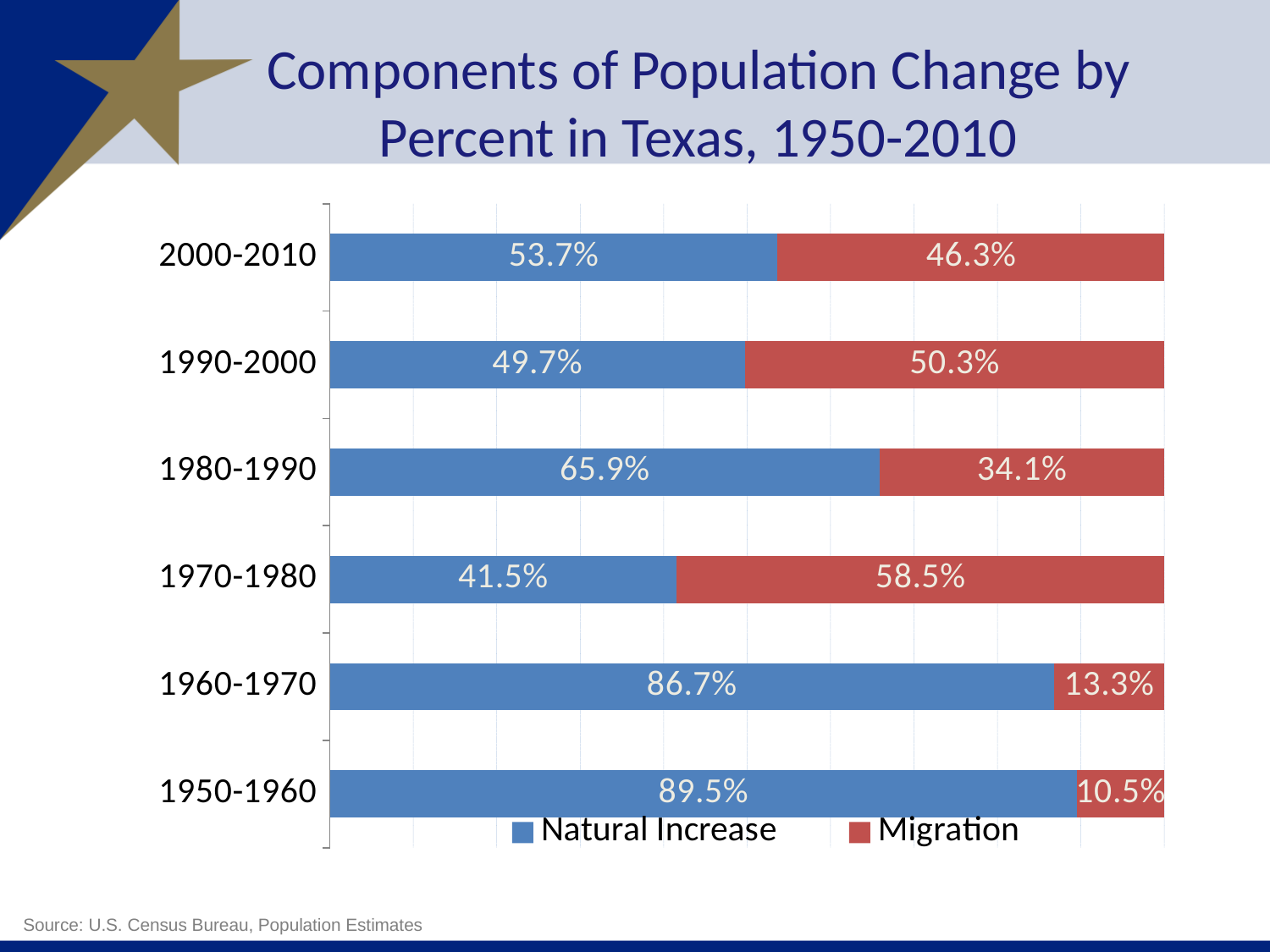
What is the Migration value for 1970-1980? 58.5% What colour represents Migration in the chart? Red How many series does the legend list? 2 What is the Migration value for 1950-1960? 10.5% What is the difference between the Natural Increase and Migration values for 1980-1990? 31.8% What is the Natural Increase value for 2000-2010? 53.7% How many time periods are shown on the chart? 6 For 1990-2000, which is larger, Natural Increase or Migration? Migration What kind of chart is shown on the slide? Stacked bar chart Which period has the highest Migration share? 1970-1980 Which period has the lowest Migration share? 1950-1960 Which period has the highest Natural Increase share? 1950-1960